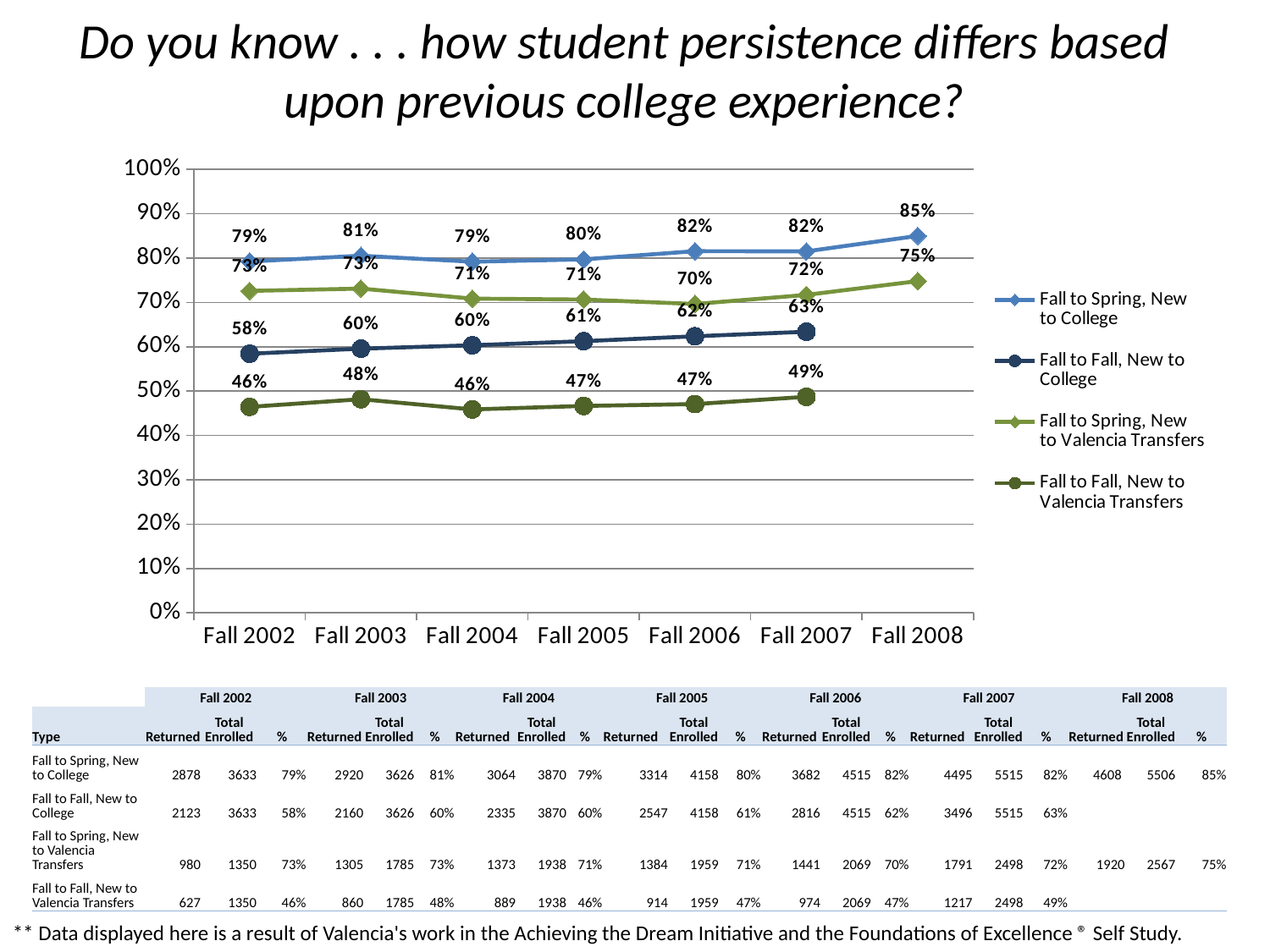
What is the value for Fall to Spring, New to Valencia Transfers in Fall 2006? 70% How many series does the chart legend list? 4 In which year does the Fall to Spring, New to College series reach its highest value? Fall 2008 What is the difference between Fall to Spring, New to College and Fall to Fall, New to College in Fall 2002? 21% What is the value for Fall to Fall, New to Valencia Transfers in Fall 2003? 48% What is the value for Fall to Spring, New to College in Fall 2008? 85% Which is larger in Fall 2007: Fall to Spring, New to College or Fall to Spring, New to Valencia Transfers? Fall to Spring, New to College Does the Fall to Fall, New to College series rise or fall from Fall 2002 to Fall 2007? rise In which year is the Fall to Spring, New to Valencia Transfers series at its lowest value? Fall 2006 Is the value for Fall to Fall, New to Valencia Transfers in Fall 2004 greater or less than 50%? less How many years are shown on the x axis of the chart? 7 What kind of chart is shown on the slide? line chart